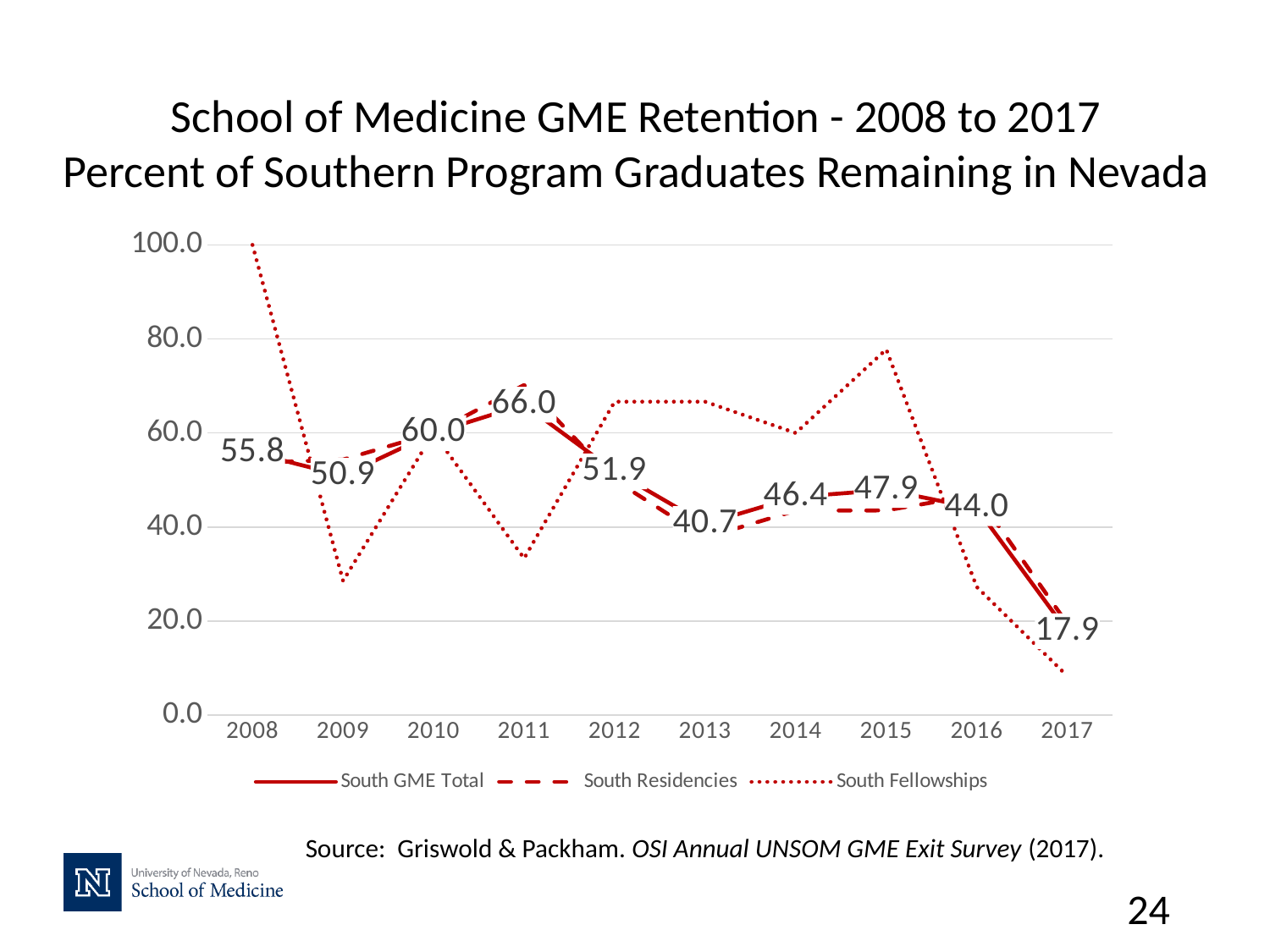
What is the South GME Total value for 2017? 17.9 How many series does the legend list? 3 In which year is the South GME Total value lowest? 2017 Is the South Fellowships value for 2009 greater or less than 40.0? less How many years are shown on the x axis? 10 What is the South GME Total value for 2013? 40.7 What is the South GME Total value for 2011? 66.0 By how much did the South GME Total value fall from 2016 to 2017? 26.1 In which year is the South GME Total value highest? 2011 What kind of chart is shown on the slide? line chart Is the South Fellowships value for 2015 greater or less than 60.0? greater Which year has the larger South GME Total value, 2010 or 2012? 2010